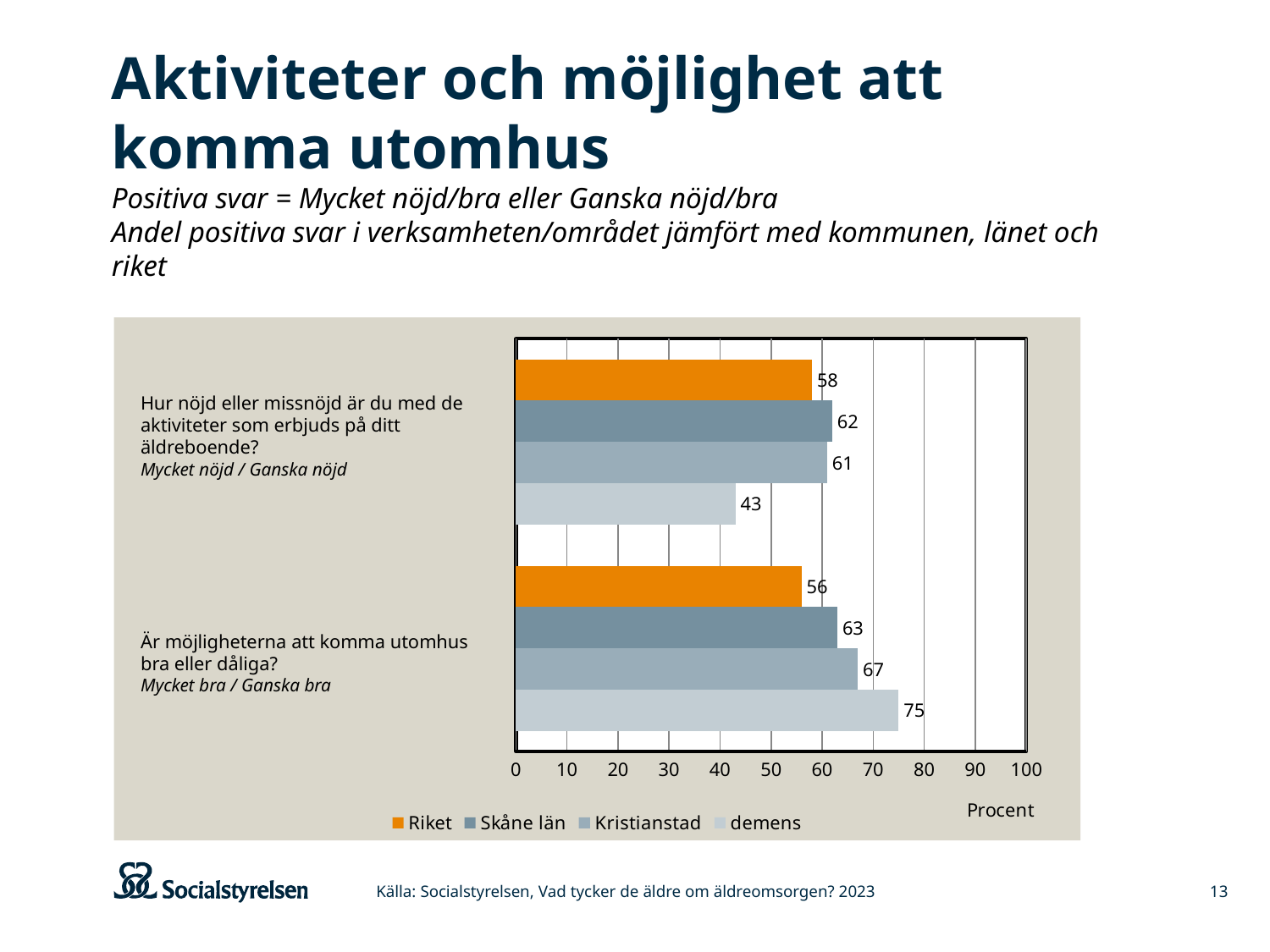
What kind of chart is shown on the slide? bar chart What is the value for Kristianstad for the question about opportunities to get outdoors ("Är möjligheterna att komma utomhus bra eller dåliga?")? 67 What is the difference between the demens value and the Riket value for the question about opportunities to get outdoors? 19 How many series does the legend list? 4 What unit is shown on the x axis of the chart? Procent What is the value for demens for the question about activities offered at the care home? 43 What is the value for Skåne län for the question about opportunities to get outdoors? 63 How many question categories are plotted on the chart? 2 For the question about activities offered at the care home, which is larger: the value for Skåne län or the value for demens? Skåne län Which series has the highest value for the question about opportunities to get outdoors? demens Which series has the lowest value for the question about activities offered at the care home? demens What is the value for Riket for the question about activities offered at the care home ("Hur nöjd eller missnöjd är du med de aktiviteter som erbjuds på ditt äldreboende?")? 58